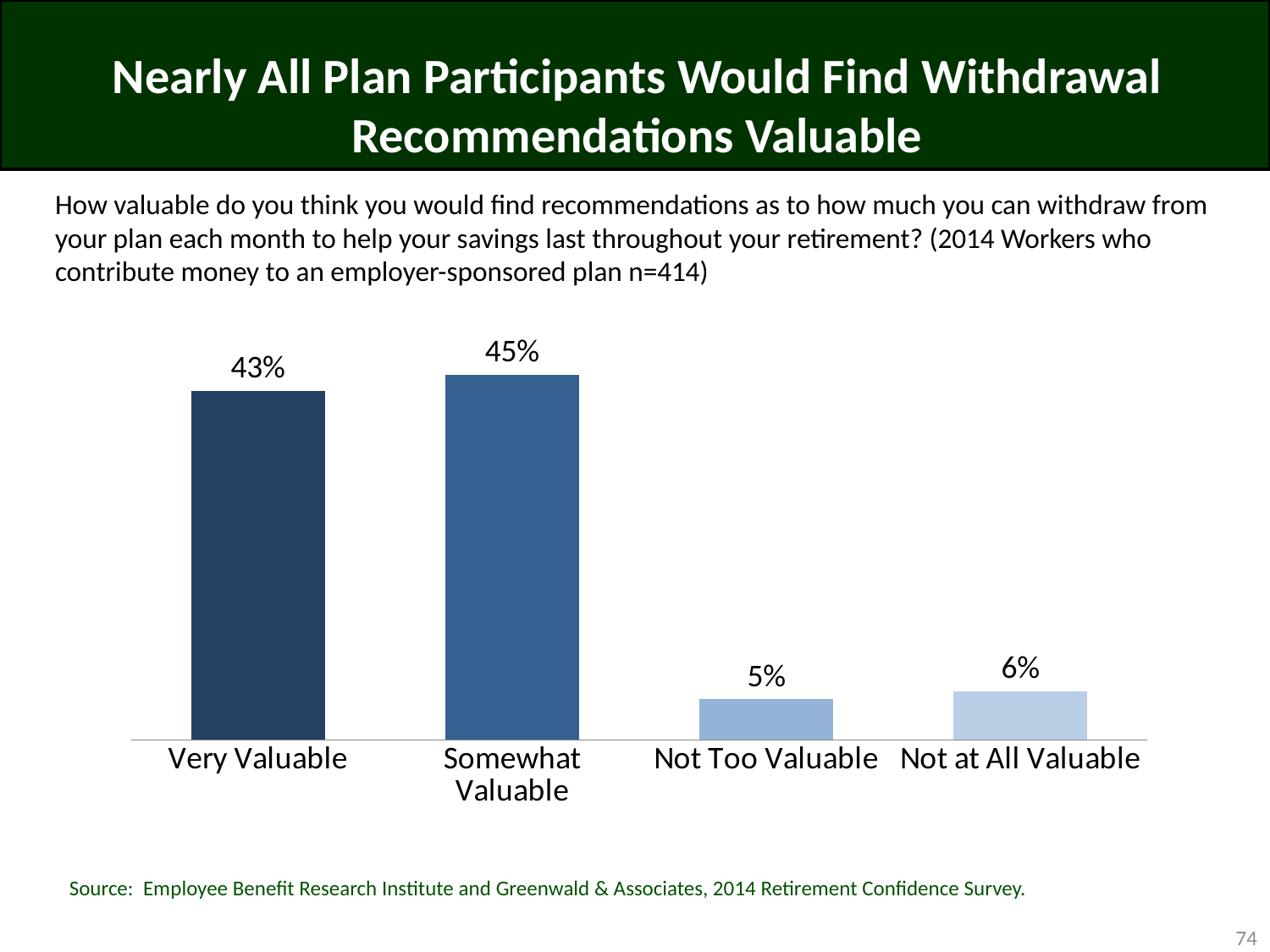
Which response category has the highest percentage? Somewhat Valuable What type of chart is shown on the slide? Bar chart What percentage of respondents said withdrawal recommendations would be Somewhat Valuable? 45% What is the combined percentage for Very Valuable and Somewhat Valuable? 88% What percentage of respondents said withdrawal recommendations would be Very Valuable? 43% How many response categories are shown in the chart? 4 What percentage of respondents said withdrawal recommendations would be Not at All Valuable? 6% Which is larger, the value for Very Valuable or the value for Not Too Valuable? Very Valuable Which response category has the lowest percentage? Not Too Valuable What is the difference in percentage points between Somewhat Valuable and Very Valuable? 2 What is the sample size (n) stated for the survey question on the slide? 414 What percentage of respondents said withdrawal recommendations would be Not Too Valuable? 5%